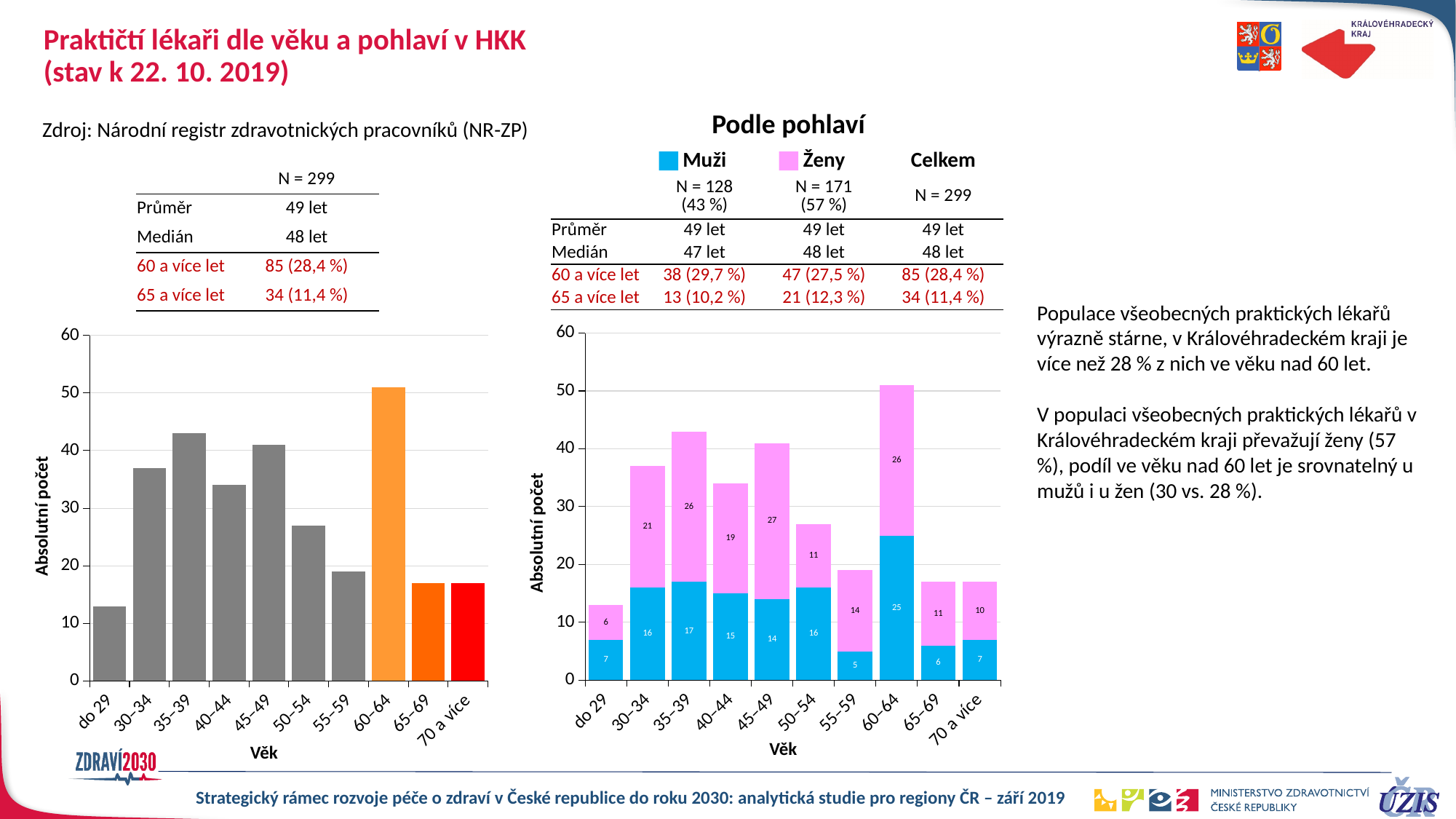
How many age groups are shown on the x axis of the left chart? 10 In the right chart (Podle pohlaví), which age group has the highest Ženy value? 45–49 In the right chart (Podle pohlaví), what is the Ženy value for the 45–49 age group? 27 What type of chart is the left chart on the slide? bar chart In the right chart (Podle pohlaví), what is the difference between the Ženy and Muži values for the 35–39 age group? 9 In the right chart (Podle pohlaví), what is the Muži value for the 60–64 age group? 25 In the left chart, is the value for the 35–39 age group greater or less than 40? greater How many series does the legend of the right chart (Podle pohlaví) list? 2 In the right chart (Podle pohlaví), which age group has the lowest Muži value? 55–59 In the right chart (Podle pohlaví), what is the total height of the stacked bar for the 30–34 age group? 37 In the right chart (Podle pohlaví), which is larger for the 'do 29' age group, Muži or Ženy? Muži In the left chart, which age group has the highest value? 60–64